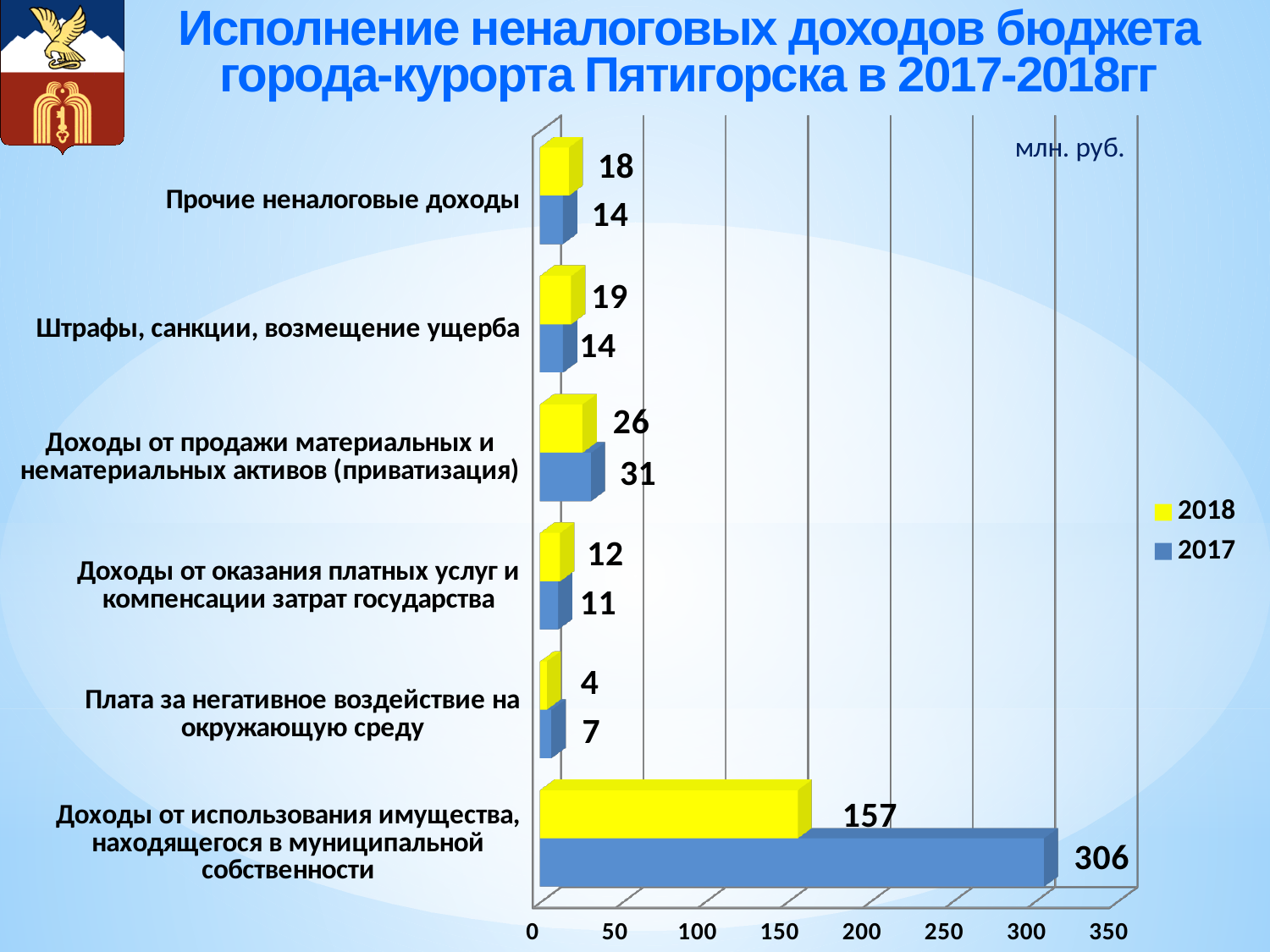
What was the 2018 value for 'Штрафы, санкции, возмещение ущерба'? 19 What kind of chart is shown on the slide? Bar chart How many series does the legend list? 2 What is the difference between the 2017 and 2018 values for 'Доходы от использования имущества, находящегося в муниципальной собственности'? 149 Which category has the lowest 2018 value? Плата за негативное воздействие на окружающую среду What was the 2017 value for 'Доходы от использования имущества, находящегося в муниципальной собственности'? 306 How many categories are shown on the chart? 6 Is the 2018 value for 'Доходы от использования имущества, находящегося в муниципальной собственности' greater or less than 150? greater What was the 2017 value for 'Доходы от продажи материальных и нематериальных активов (приватизация)'? 31 For 'Прочие неналоговые доходы', which year had the larger value, 2017 or 2018? 2018 Which category has the highest 2017 value? Доходы от использования имущества, находящегося в муниципальной собственности For 'Плата за негативное воздействие на окружающую среду', which year had the larger value, 2017 or 2018? 2017